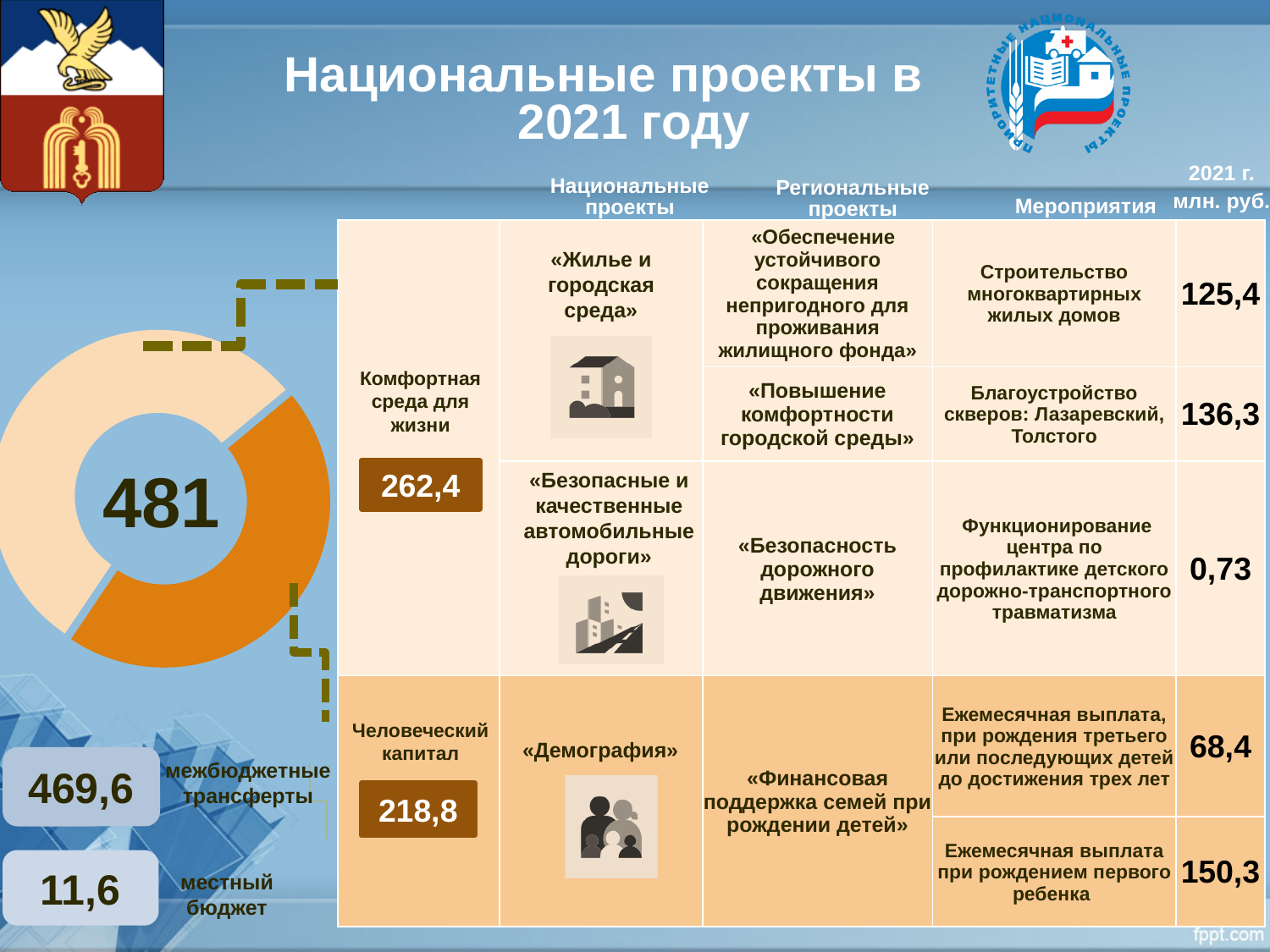
What is the title of the slide containing the donut chart? Национальные проекты в 2021 году Which of the two directions linked to the donut chart has the smaller value? Человеческий капитал What unit is stated for the 2021 values on the slide? млн. руб. What is the value shown for «Человеческий капитал»? 218,8 Which has the larger value, «Комфортная среда для жизни» or «Человеческий капитал»? Комфортная среда для жизни What is the value shown for «Комфортная среда для жизни»? 262,4 What is the difference between the values for «Комфортная среда для жизни» (262,4) and «Человеческий капитал» (218,8)? 43,6 What kind of chart is shown on the left of the slide? Donut (pie) chart What value is printed in the centre of the donut chart? 481 How many slices does the donut chart have? 2